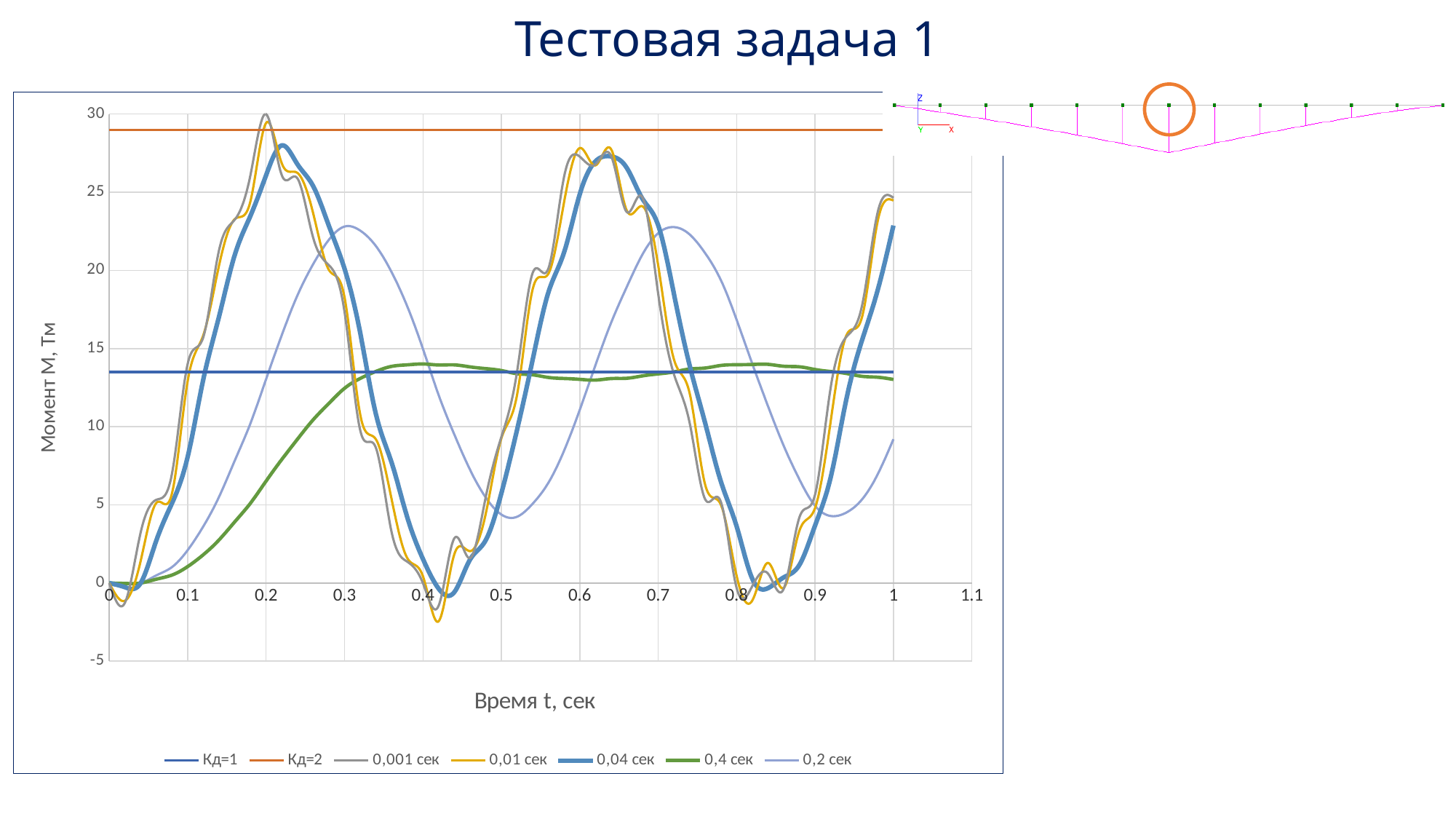
Is the value of the 0,2 сек series at t = 0.3 greater or less than 20? greater What is the title of the horizontal axis of the chart? Время t, сек At t = 0.3, which series has the larger value: 0,2 сек or 0,4 сек? 0,2 сек What kind of chart is shown on the slide? Line chart Is the value of the 0,04 сек series at t = 0.4 greater or less than 5? less Does the 0,4 сек series rise or fall between t = 0 and t = 0.3? rise How many series does the legend of the chart list? 7 At t = 0.4, which series has the larger value: 0,4 сек or 0,04 сек? 0,4 сек Which of the two horizontal lines, Кд=1 or Кд=2, has the larger value? Кд=2 Is the value of the Кд=2 line greater or less than 25? greater What is the title of the vertical axis of the chart? Момент М, Тм